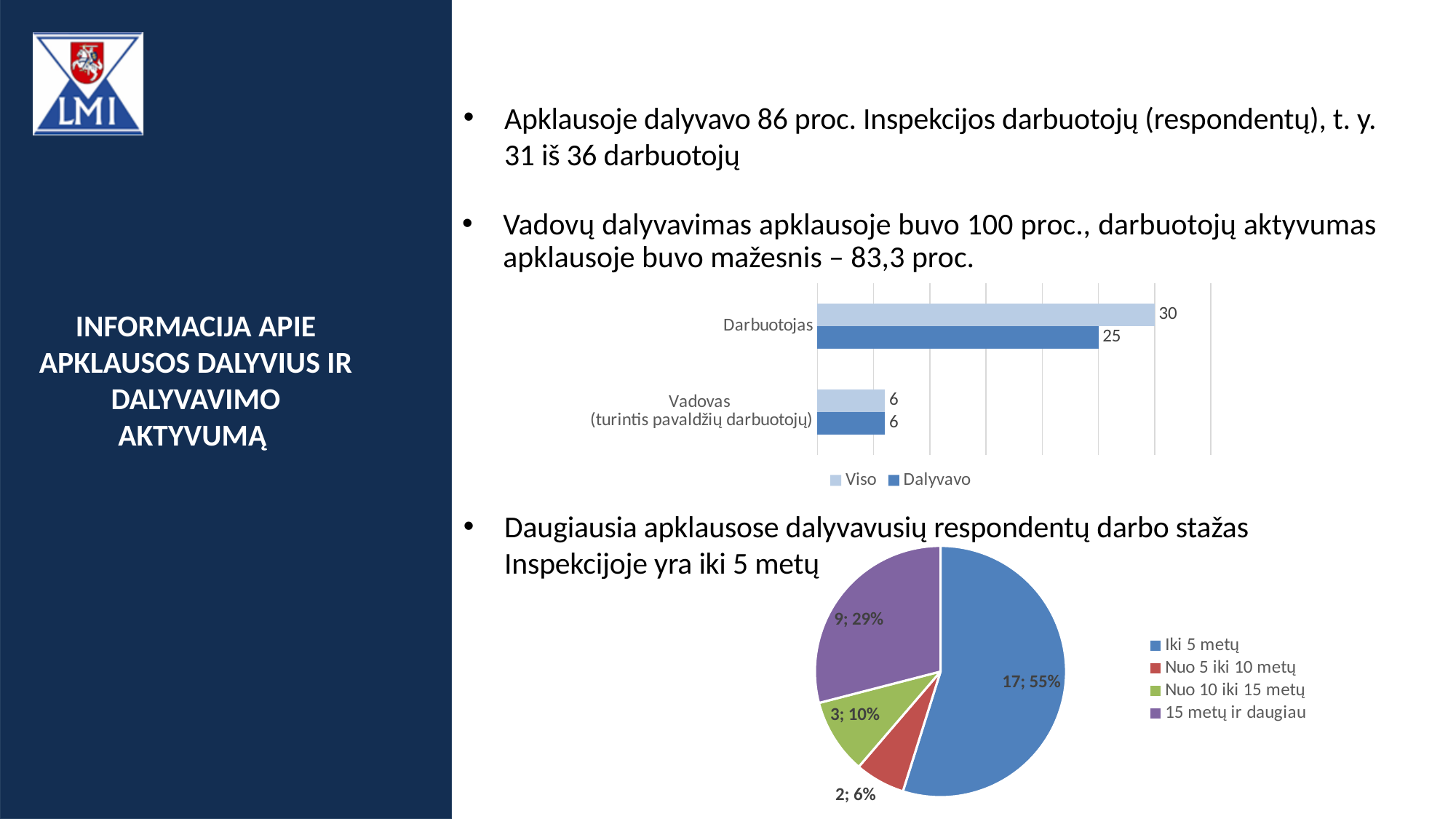
In the bar chart at the top of the slide, how many series does the legend list? 2 In the bar chart at the top of the slide, what is the Viso value for Darbuotojas? 30 In the pie chart at the bottom of the slide, how many categories are shown? 4 In the bar chart at the top of the slide, which category has the higher Viso value, Darbuotojas or Vadovas (turintis pavaldžių darbuotojų)? Darbuotojas In the pie chart at the bottom of the slide, what is the count for 15 metų ir daugiau? 9 In the bar chart at the top of the slide, what is the Dalyvavo value for Darbuotojas? 25 In the bar chart at the top of the slide, what is the difference between the Viso and Dalyvavo values for Darbuotojas? 5 In the pie chart at the bottom of the slide, which category has the smallest slice? Nuo 5 iki 10 metų In the pie chart at the bottom of the slide, what is the difference between the counts for Nuo 10 iki 15 metų and Nuo 5 iki 10 metų? 1 In the bar chart at the top of the slide, what is the Dalyvavo value for Vadovas (turintis pavaldžių darbuotojų)? 6 What kind of chart is the chart at the top of the slide? Bar chart In the pie chart at the bottom of the slide, what share does Iki 5 metų have? 55%